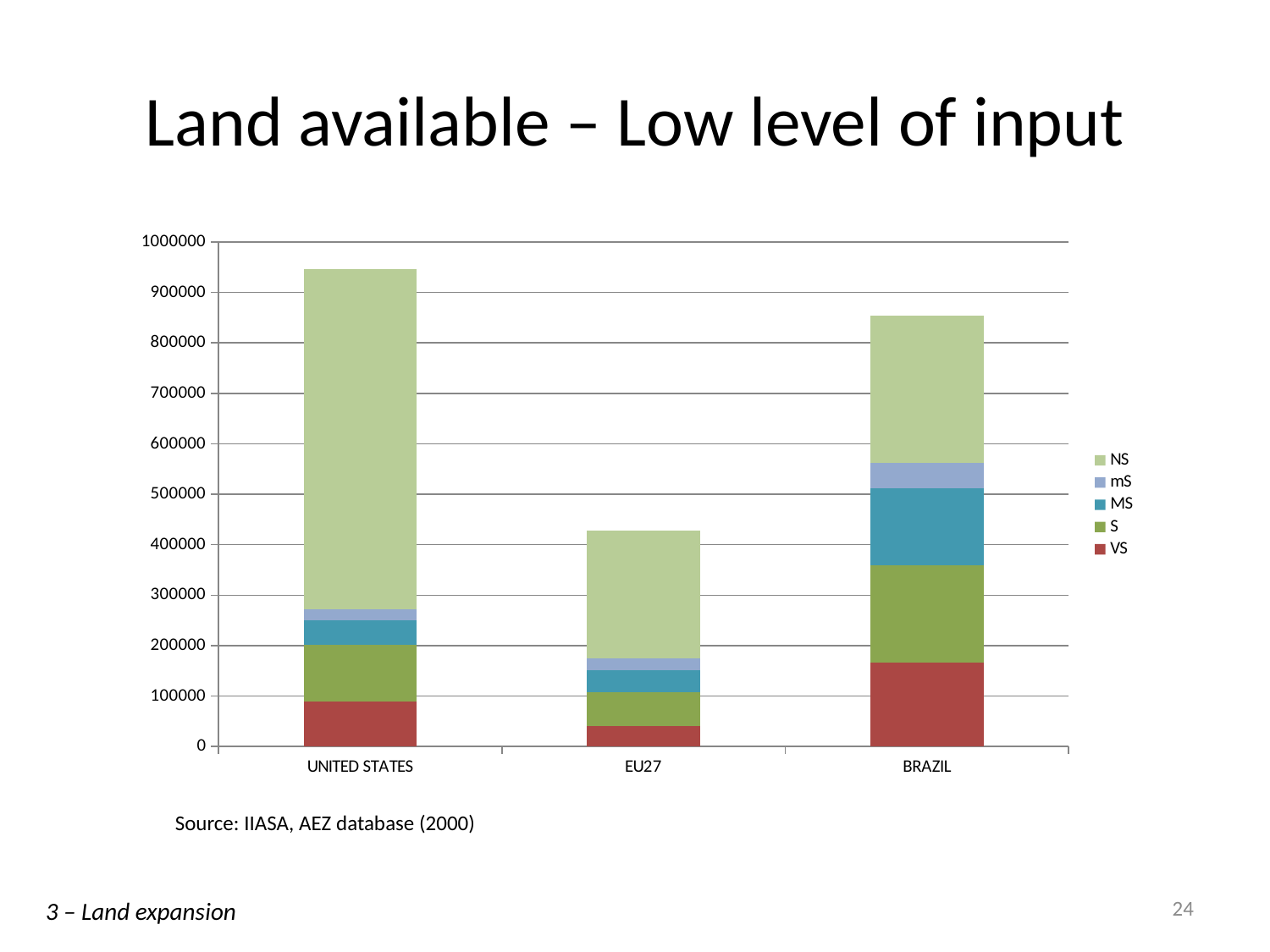
Is the VS segment for BRAZIL greater or less than 100000? greater Which country or region has the shortest stacked bar? EU27 Is the total stacked bar for EU27 greater or less than 500000? less Is the total stacked bar for BRAZIL greater or less than 800000? greater How many series does the legend list? 5 Which country or region has the tallest stacked bar? UNITED STATES How many countries or regions are shown on the x axis? 3 Which has the larger VS segment, UNITED STATES or BRAZIL? BRAZIL What kind of chart is shown on the slide? Stacked bar chart What is the title of the slide containing the chart? Land available – Low level of input Which has the larger NS segment, UNITED STATES or BRAZIL? UNITED STATES